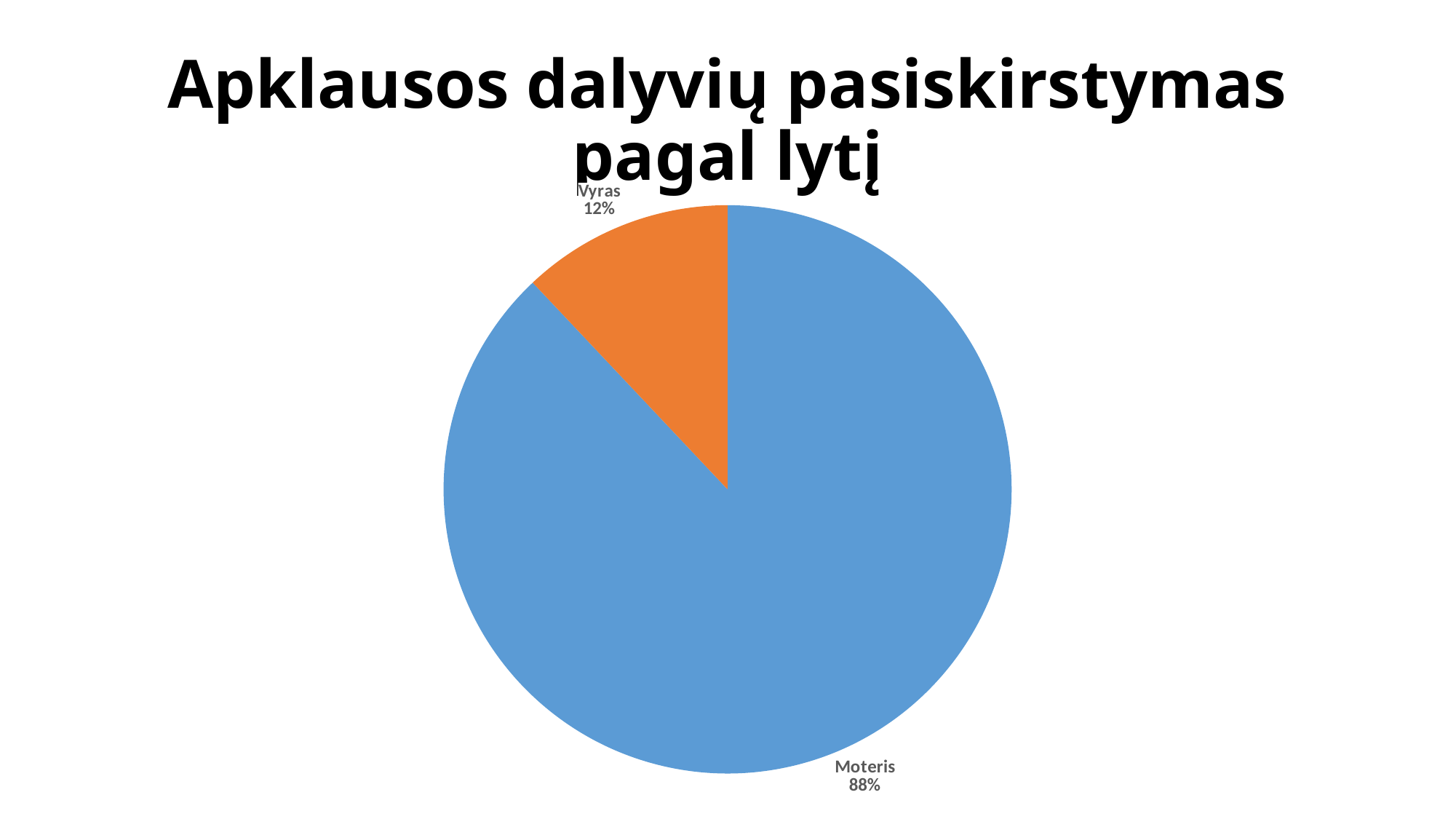
How many slices does the pie chart have? 2 What colour is the Vyras slice? orange What share of the pie does Vyras have? 12% What is the difference in percentage points between Moteris and Vyras? 76 Which category has the largest slice? Moteris What is the title of the chart? Apklausos dalyvių pasiskirstymas pagal lytį Which is larger, the Moteris slice or the Vyras slice? Moteris What share of the pie does Moteris have? 88% Which category has the smallest slice? Vyras What kind of chart is shown on the slide? pie chart